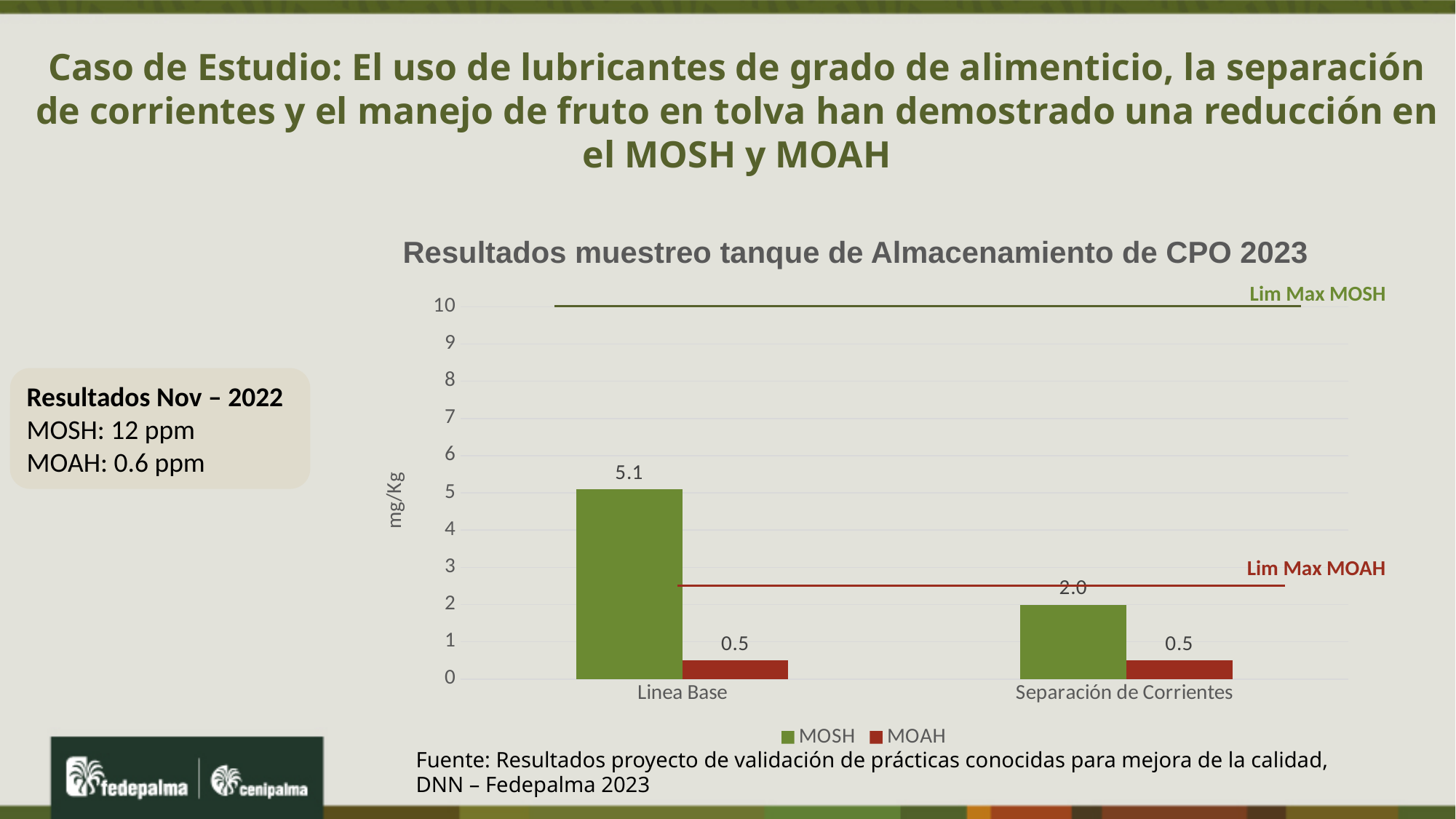
What is the MOAH value for Linea Base? 0.5 Which category has the highest MOSH value? Linea Base What is the MOSH value for Linea Base? 5.1 What is the difference between the MOSH values for Linea Base and Separación de Corrientes? 3.1 Is the MOSH value for Linea Base greater or less than 5? greater What kind of chart is shown on the slide? bar chart How many categories are shown on the x axis? 2 Which is larger, the MOSH value for Linea Base or the MOSH value for Separación de Corrientes? Linea Base What is the MOSH value for Separación de Corrientes? 2.0 How many series does the legend list? 2 What is the title of the chart? Resultados muestreo tanque de Almacenamiento de CPO 2023 What is the MOAH value for Separación de Corrientes? 0.5